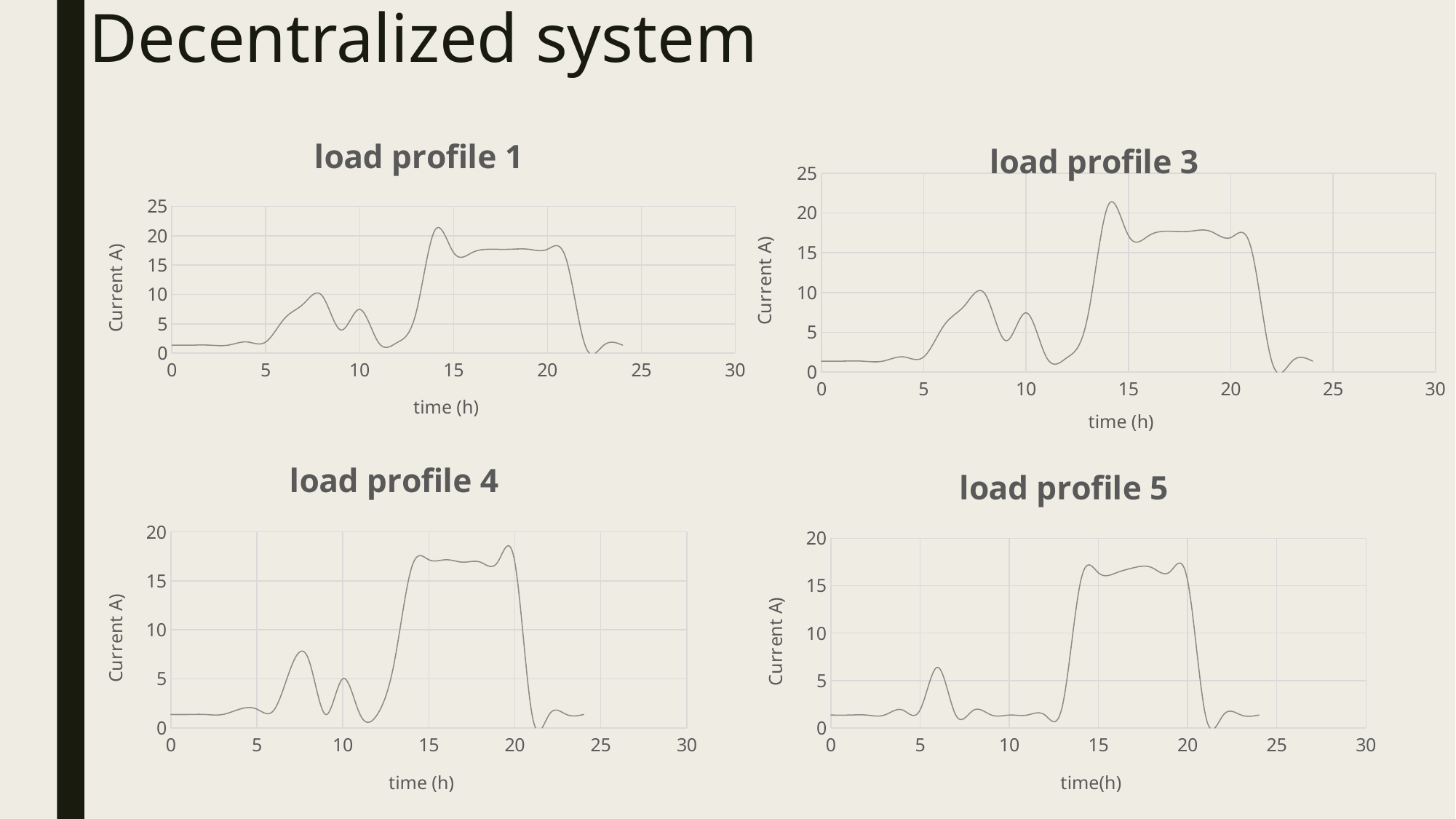
What kind of chart is the "load profile 1" chart? line chart In the "load profile 4" chart, is the value at 16 h greater or less than 15? greater What is the x-axis label of the "load profile 4" chart? time (h) In the "load profile 1" chart, is the peak value reached around 14 h greater or less than 20? greater In the "load profile 4" chart, is the highest value on the curve greater or less than 20? less What is the highest tick value shown on the y-axis of the "load profile 3" chart? 25 How many charts are shown on the slide? 4